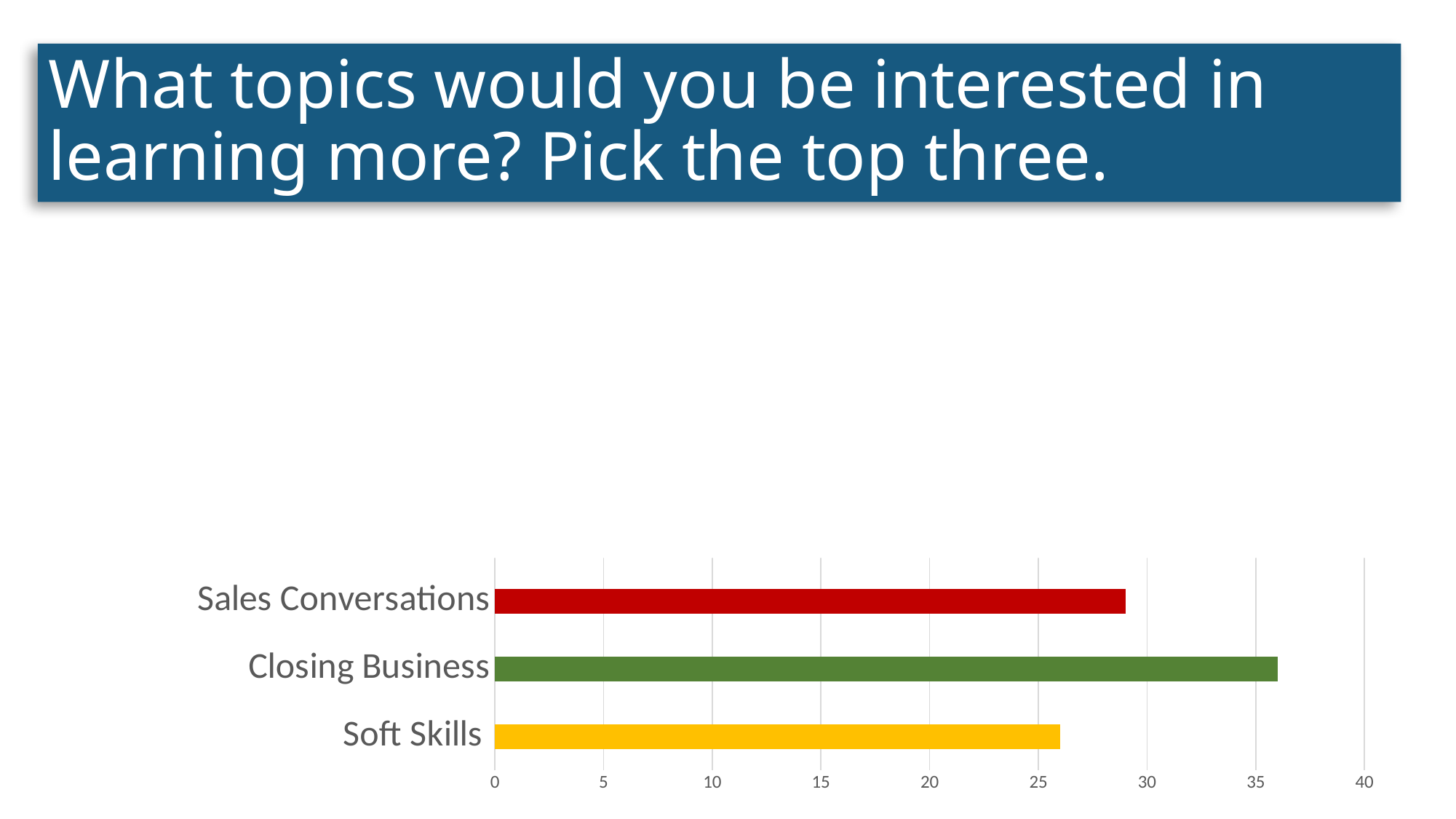
How many categories are plotted in the chart? 3 Is the value for Closing Business greater or less than 40? less Is the value for Closing Business greater or less than 30? greater Is the value for Soft Skills greater or less than 30? less Which category has the highest value? Closing Business What colour is the bar for Closing Business? green Which is larger, the value for Closing Business or the value for Sales Conversations? Closing Business What kind of chart is shown on the slide? bar chart Which category has the lowest value? Soft Skills Which is larger, the value for Sales Conversations or the value for Soft Skills? Sales Conversations